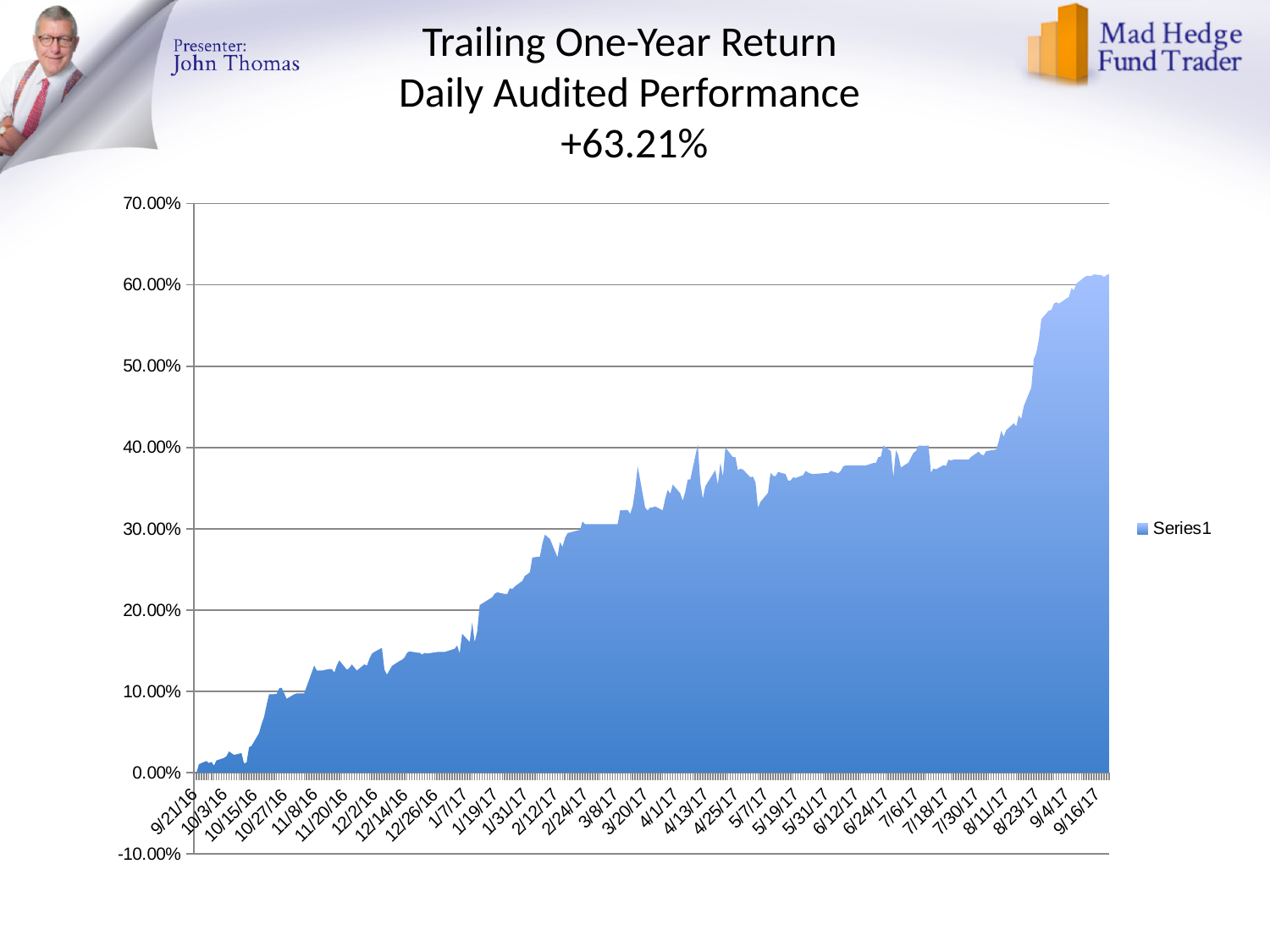
Do the values generally rise or fall from 9/21/16 to 9/16/17? rise Is the value for 1/7/17 greater or less than 10%? greater Is the value for 9/16/17 greater or less than 50%? greater What is the name of the series shown in the legend? Series1 Is the value for 1/7/17 greater or less than 20%? less How many series does the legend list? 1 What trailing one-year return figure is stated in the chart title? +63.21% Which is larger, the value for 9/16/17 or the value for 4/13/17? 9/16/17 What kind of chart is shown on the slide? area chart